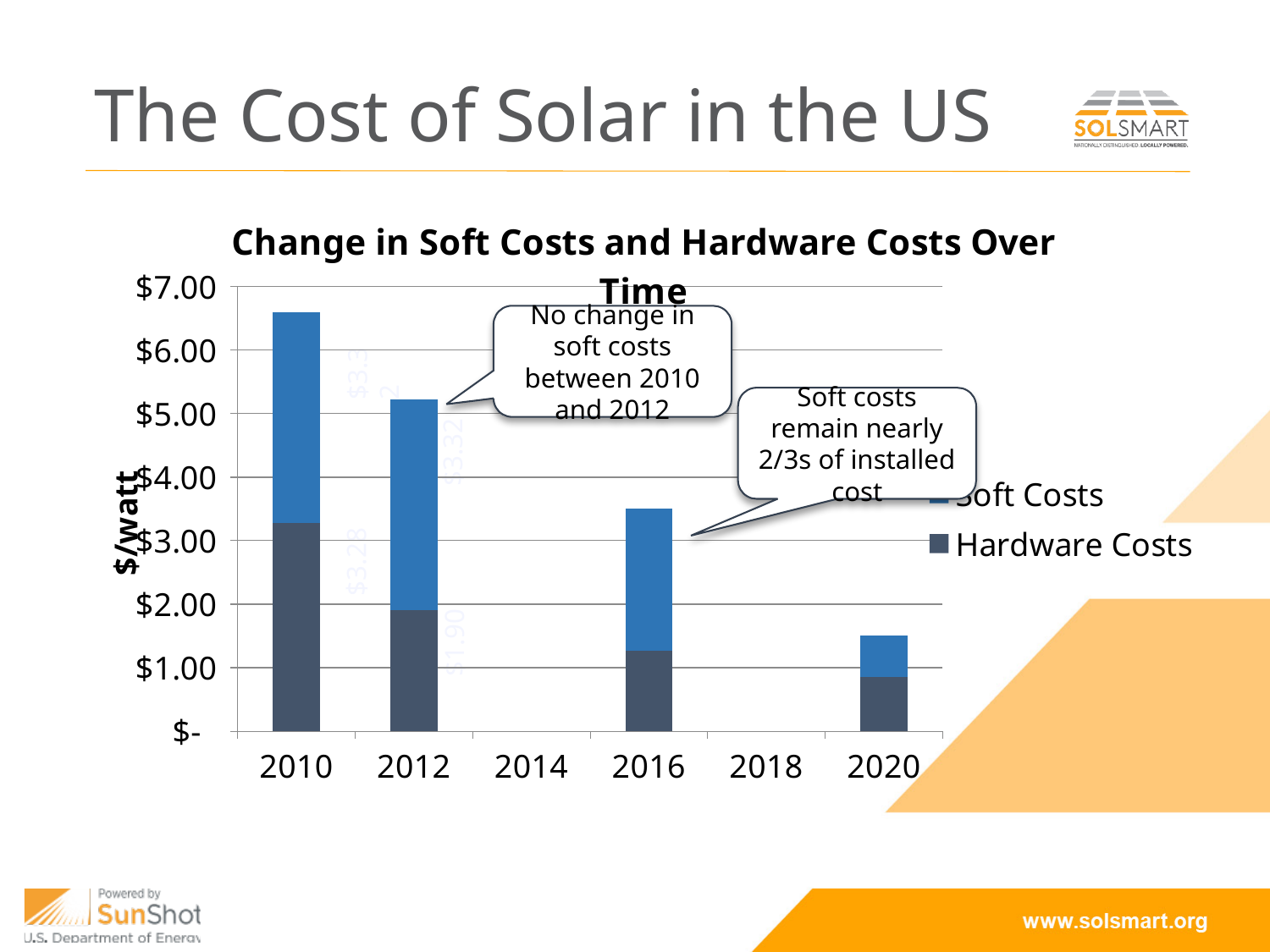
Is the Hardware Costs value for 2016 greater or less than $2.00? less How many years have bars plotted in the chart? 4 Which year has the larger total cost, 2012 or 2016? 2012 What are the two series named in the legend? Soft Costs and Hardware Costs Do the total costs rise or fall from 2010 to 2020? Fall Is the total cost for 2010 greater or less than $6.00? greater Which year has the highest total installed cost? 2010 What is the label on the vertical axis? $/watt Is the total cost for 2020 greater or less than $2.00? less How many series does the legend list? 2 Which year has the lowest total installed cost? 2020 What kind of chart is shown on the slide? Stacked bar chart